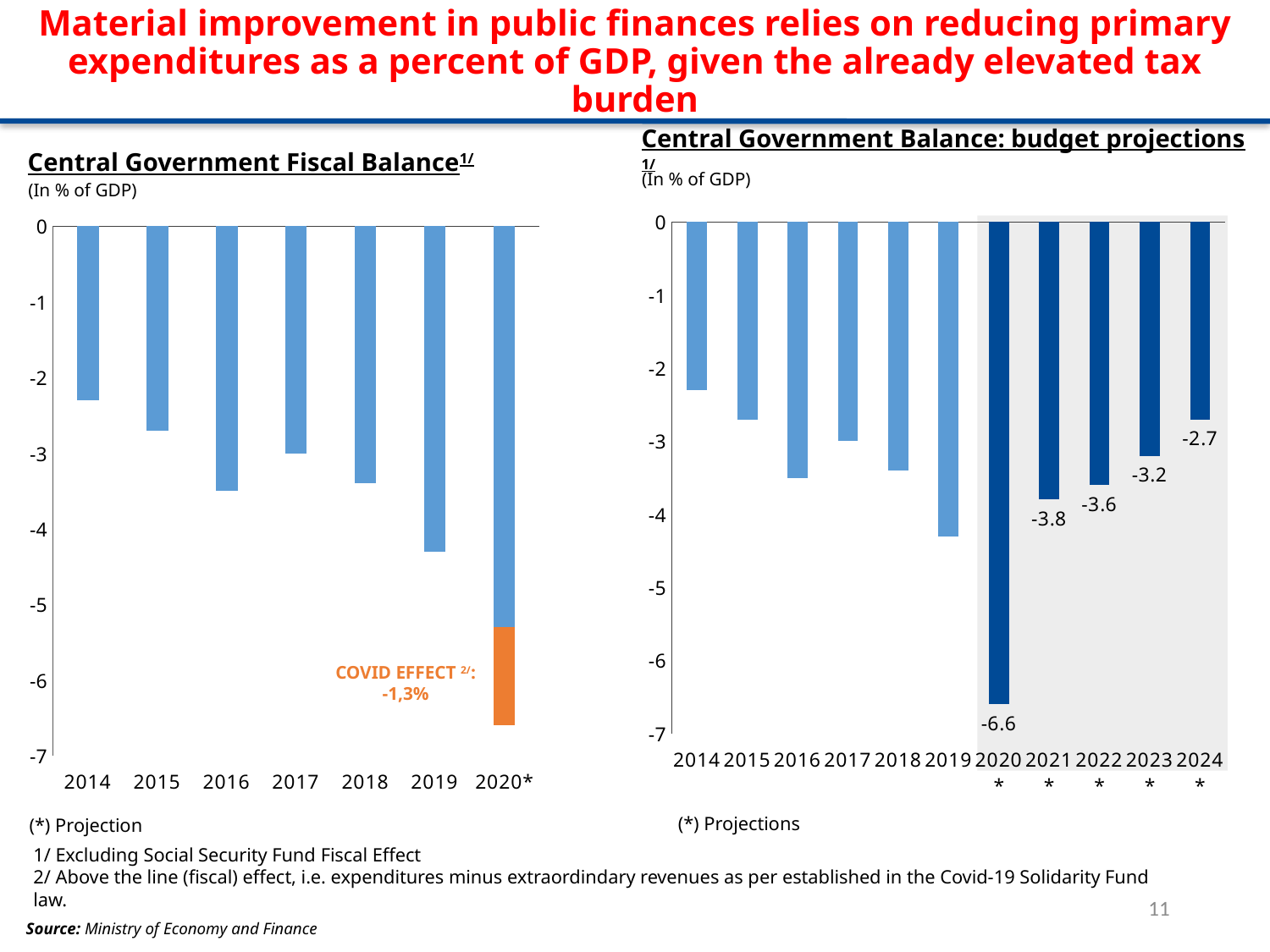
In the 'Central Government Balance: budget projections' chart, which value is larger, 2022 or 2023? 2023 In the 'Central Government Balance: budget projections' chart, how many years are shown on the x axis? 11 In the 'Central Government Balance: budget projections' chart, what is the value for 2024? -2.7 In the 'Central Government Fiscal Balance' chart, what COVID effect value is labelled on the 2020* bar? -1,3% In the 'Central Government Balance: budget projections' chart, what is the difference between the 2023 and 2024 values? 0.5 In the 'Central Government Balance: budget projections' chart, what is the difference between the 2020 and 2021 values? 2.8 In the 'Central Government Balance: budget projections' chart, what is the value for 2020? -6.6 In the 'Central Government Balance: budget projections' chart, what is the value for 2022? -3.6 In the 'Central Government Balance: budget projections' chart, which year has the lowest (most negative) balance? 2020 In the 'Central Government Fiscal Balance' chart, how many years are shown on the x axis? 7 In the 'Central Government Fiscal Balance' chart, is the value for 2019 greater or less than -4? less In the 'Central Government Balance: budget projections' chart, do the values rise or fall from 2020 to 2024? rise